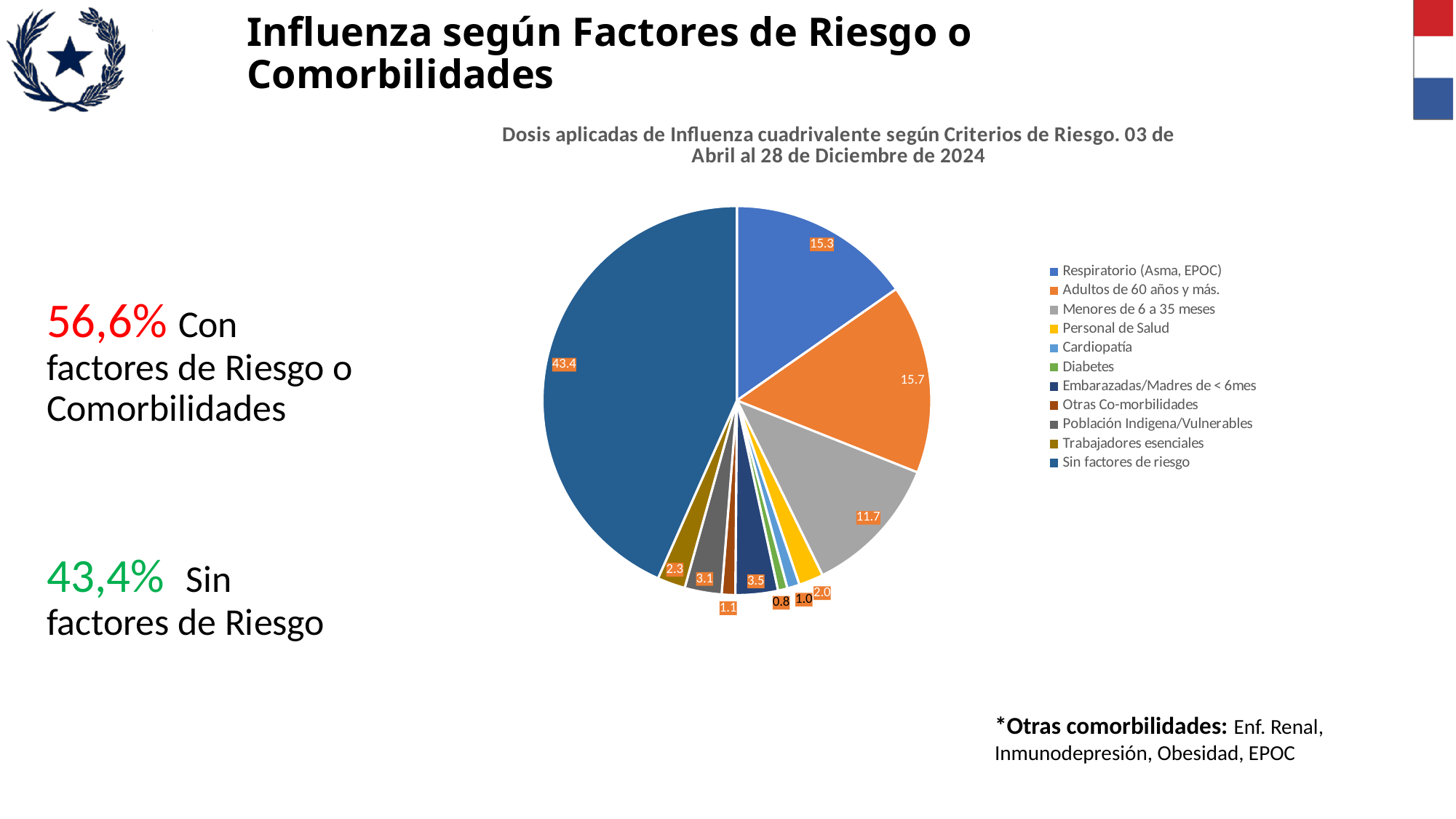
What is the value shown for the 'Embarazadas/Madres de < 6mes' slice? 3.5 What is the value shown for the 'Menores de 6 a 35 meses' slice? 11.7 What is the title of the pie chart? Dosis aplicadas de Influenza cuadrivalente según Criterios de Riesgo. 03 de Abril al 28 de Diciembre de 2024 What is the value shown for the 'Sin factores de riesgo' slice? 43.4 What is the value shown for the 'Adultos de 60 años y más.' slice? 15.7 Which is larger, the value for 'Población Indigena/Vulnerables' or for 'Trabajadores esenciales'? Población Indigena/Vulnerables How many categories does the legend of the pie chart list? 11 What kind of chart is shown on the slide? pie chart What is the value shown for the 'Personal de Salud' slice? 2.0 Which category has the largest slice of the pie? Sin factores de riesgo Which category has the smallest slice of the pie? Diabetes What is the difference between the values for 'Adultos de 60 años y más.' and 'Respiratorio (Asma, EPOC)'? 0.4